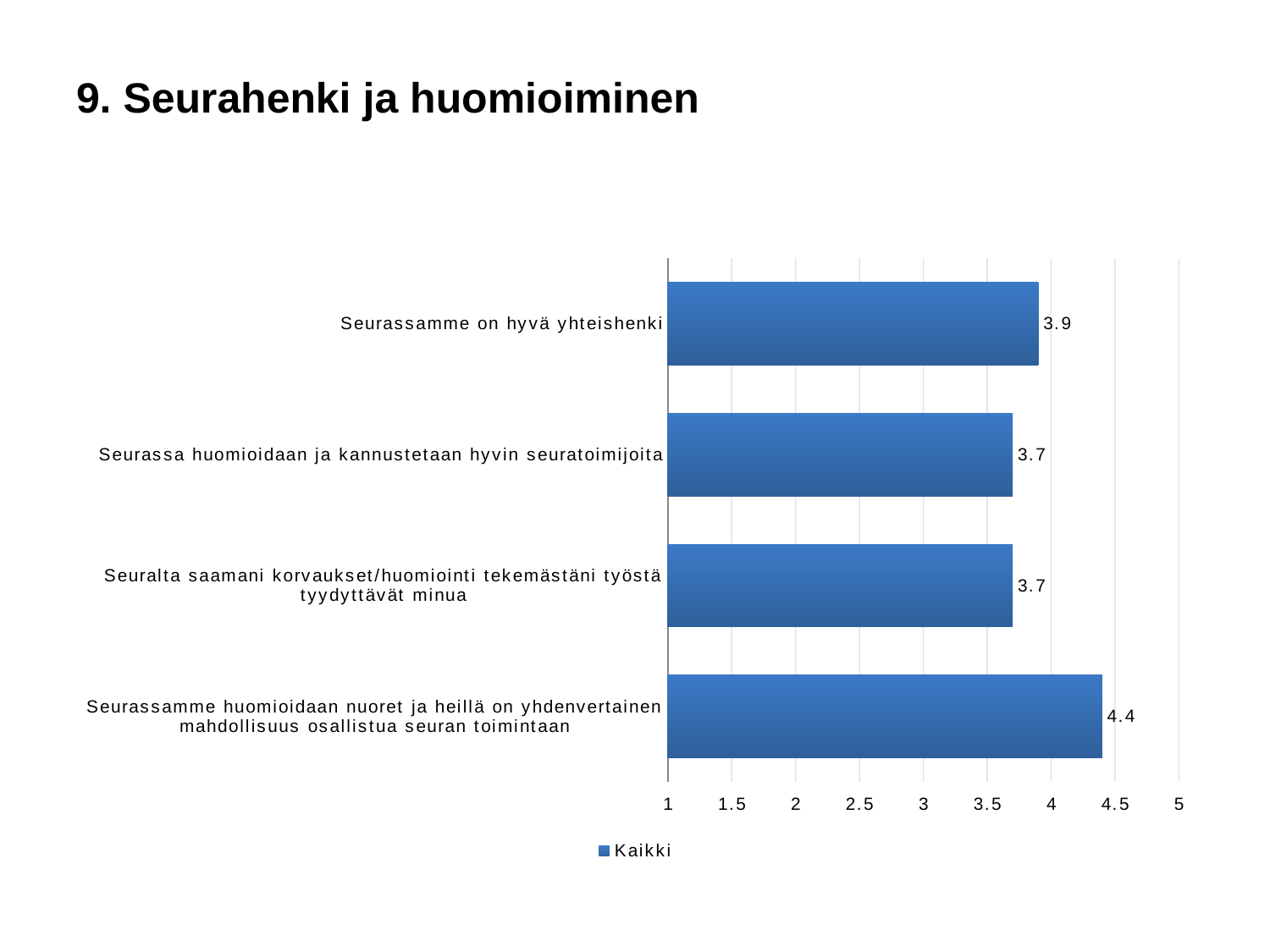
What is the value for "Seurassa huomioidaan ja kannustetaan hyvin seuratoimijoita"? 3.7 What is the value for "Seurassamme on hyvä yhteishenki"? 3.9 Which category has the highest value? Seurassamme huomioidaan nuoret ja heillä on yhdenvertainen mahdollisuus osallistua seuran toimintaan What is the title of the slide? 9. Seurahenki ja huomioiminen How many categories are shown in the chart? 4 Which is larger: the value for "Seurassamme on hyvä yhteishenki" or the value for "Seurassa huomioidaan ja kannustetaan hyvin seuratoimijoita"? Seurassamme on hyvä yhteishenki What is the value for "Seurassamme huomioidaan nuoret ja heillä on yhdenvertainen mahdollisuus osallistua seuran toimintaan"? 4.4 What is the difference between the value for "Seurassamme huomioidaan nuoret ja heillä on yhdenvertainen mahdollisuus osallistua seuran toimintaan" and the value for "Seurassamme on hyvä yhteishenki"? 0.5 Is the value for "Seuralta saamani korvaukset/huomiointi tekemästäni työstä tyydyttävät minua" greater or less than 4? less How many series does the legend list? 1 What is the name of the series shown in the legend? Kaikki What kind of chart is shown on the slide? bar chart